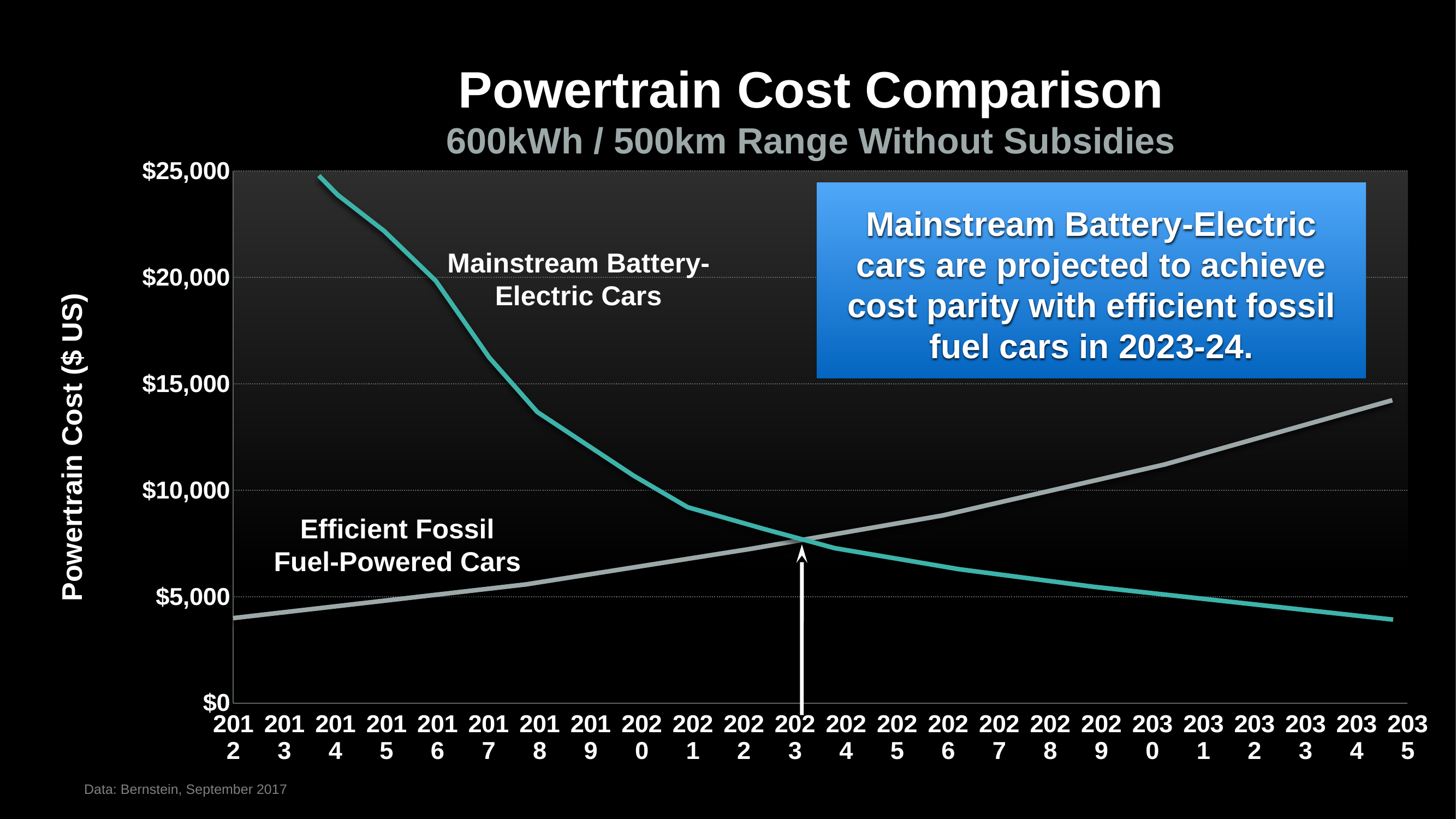
How many data series are plotted on the chart? 2 Is the value for Efficient Fossil Fuel-Powered Cars in 2035 greater or less than $10,000? greater How many years are labelled along the x axis of the chart? 24 What is the title of the chart? Powertrain Cost Comparison Does the Mainstream Battery-Electric Cars line rise or fall from 2014 to 2035? fall What kind of chart is shown on the slide? line chart Is the value for Mainstream Battery-Electric Cars in 2035 greater or less than $5,000? less Is the value for Efficient Fossil Fuel-Powered Cars in 2012 greater or less than $5,000? less Does the Efficient Fossil Fuel-Powered Cars line rise or fall from 2012 to 2035? rise In 2030, which series has the higher powertrain cost: Mainstream Battery-Electric Cars or Efficient Fossil Fuel-Powered Cars? Efficient Fossil Fuel-Powered Cars In 2016, which series has the higher powertrain cost: Mainstream Battery-Electric Cars or Efficient Fossil Fuel-Powered Cars? Mainstream Battery-Electric Cars